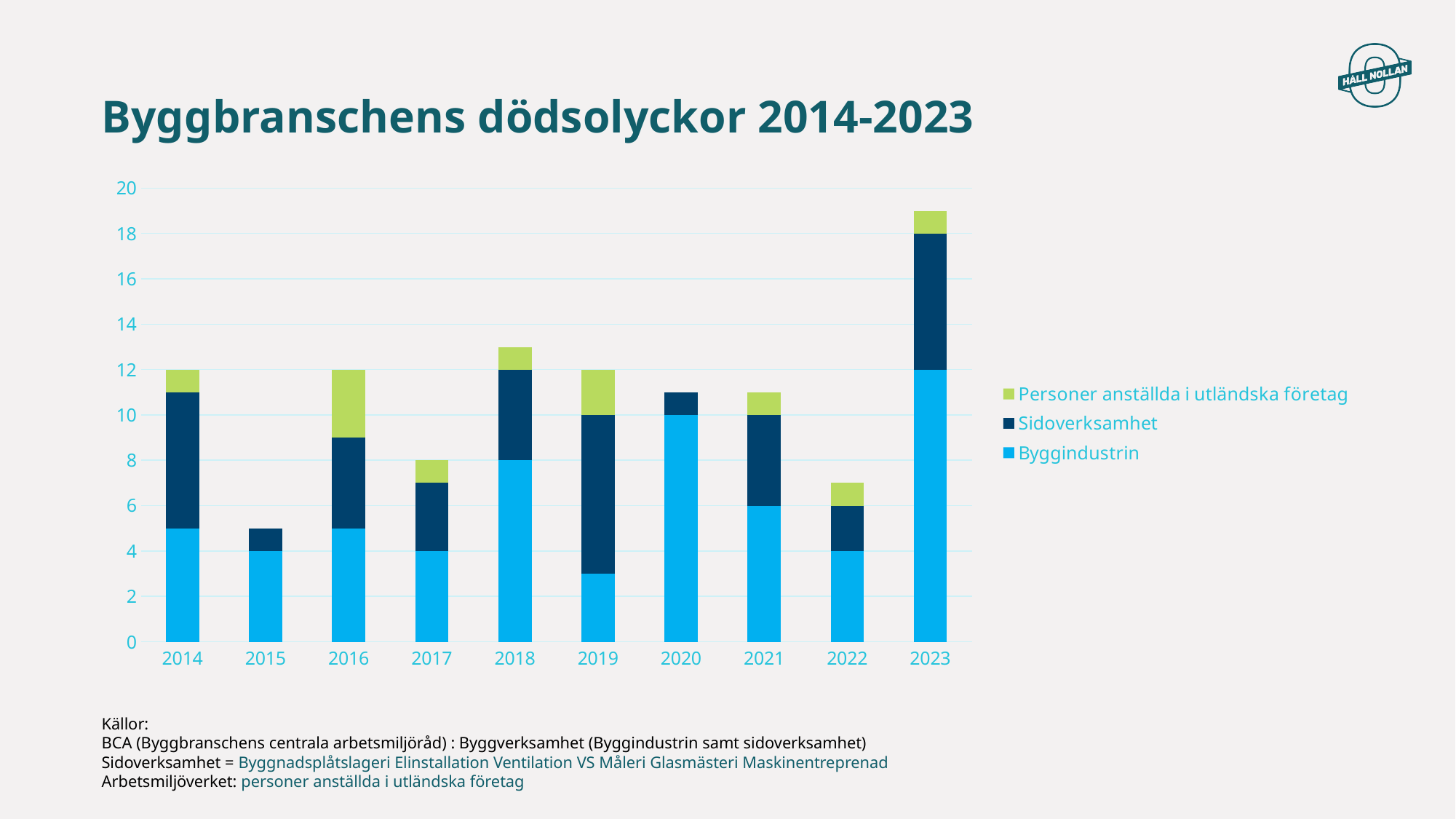
What is the value for Byggindustrin in 2018? 8 Which year has the larger total, 2018 or 2017? 2018 Which year has the lowest total number of fatal accidents? 2015 Is the total for 2023 greater or less than 18? greater What is the title of the chart? Byggbranschens dödsolyckor 2014-2023 What is the value for Byggindustrin in 2023? 12 Which year has the highest total number of fatal accidents? 2023 How many years are shown on the x axis? 10 What is the total of the stacked bar for 2017? 8 How many series does the legend list? 3 What is the value for Byggindustrin in 2020? 10 What kind of chart is shown on the slide? bar chart